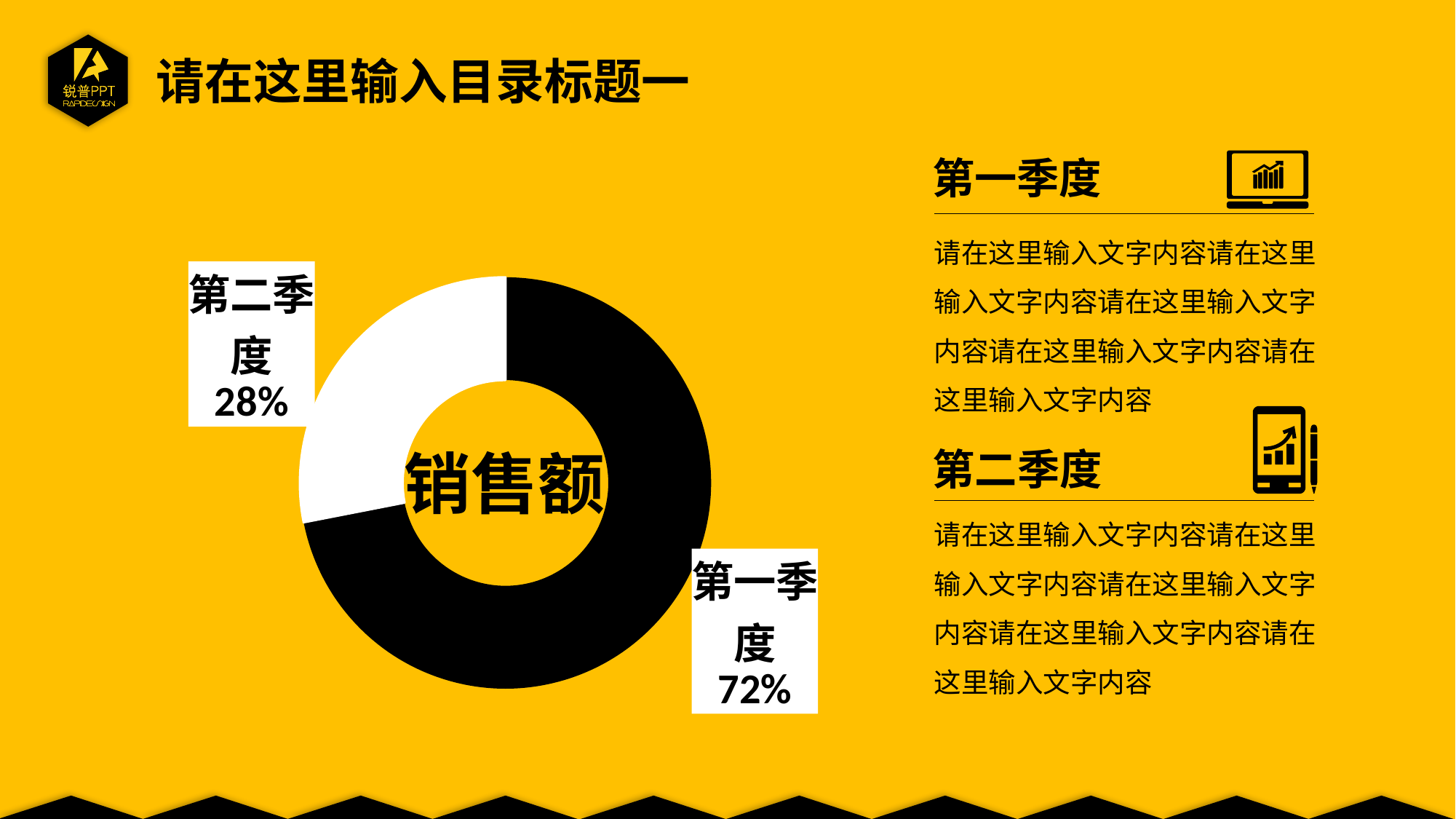
What kind of chart is shown on the slide? Doughnut chart How many categories are shown in the doughnut chart? 2 What percentage is shown for 第二季度 in the doughnut chart? 28% What percentage is shown for 第一季度 in the doughnut chart? 72% Which category has the smallest share in the doughnut chart? 第二季度 What is the title shown in the centre of the doughnut chart? 销售额 Which is larger in the doughnut chart, 第一季度 or 第二季度? 第一季度 What is the total of the two percentages shown in the doughnut chart? 100% What is the difference in percentage points between 第一季度 and 第二季度 in the doughnut chart? 44 Which category has the largest share in the doughnut chart? 第一季度 What colour is the 第一季度 slice in the doughnut chart? Black